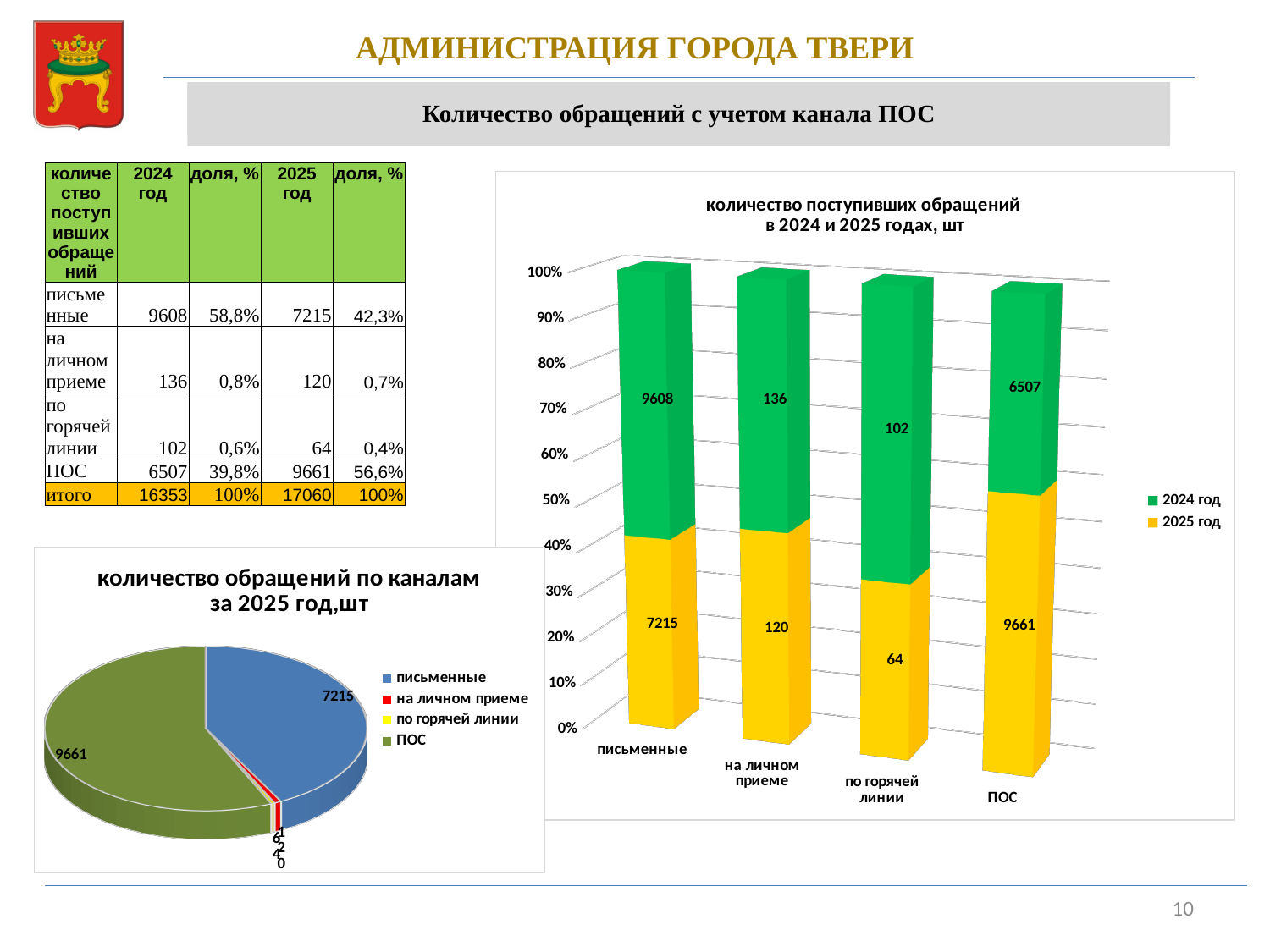
In the bar chart 'количество поступивших обращений в 2024 и 2025 годах, шт', what is the value for на личном приеме in 2024 год? 136 In the bar chart 'количество поступивших обращений в 2024 и 2025 годах, шт', what is the difference between the 2024 год and 2025 год values for письменные? 2393 In the bar chart 'количество поступивших обращений в 2024 и 2025 годах, шт', which category has the highest value for 2025 год? ПОС In the bar chart 'количество поступивших обращений в 2024 и 2025 годах, шт', what is the value for ПОС in 2025 год? 9661 In the pie chart 'количество обращений по каналам за 2025 год,шт', what is the value for ПОС? 9661 What kind of chart is 'количество обращений по каналам за 2025 год,шт'? pie chart In the bar chart 'количество поступивших обращений в 2024 и 2025 годах, шт', which is larger for ПОС: the 2024 год value or the 2025 год value? 2025 год In the bar chart 'количество поступивших обращений в 2024 и 2025 годах, шт', what is the value for по горячей линии in 2025 год? 64 In the bar chart 'количество поступивших обращений в 2024 и 2025 годах, шт', what is the value for письменные in 2024 год? 9608 In the bar chart 'количество поступивших обращений в 2024 и 2025 годах, шт', which category has the lowest value for 2024 год? по горячей линии In the bar chart 'количество поступивших обращений в 2024 и 2025 годах, шт', how many series does the legend list? 2 In the bar chart 'количество поступивших обращений в 2024 и 2025 годах, шт', how many categories are shown on the x axis? 4